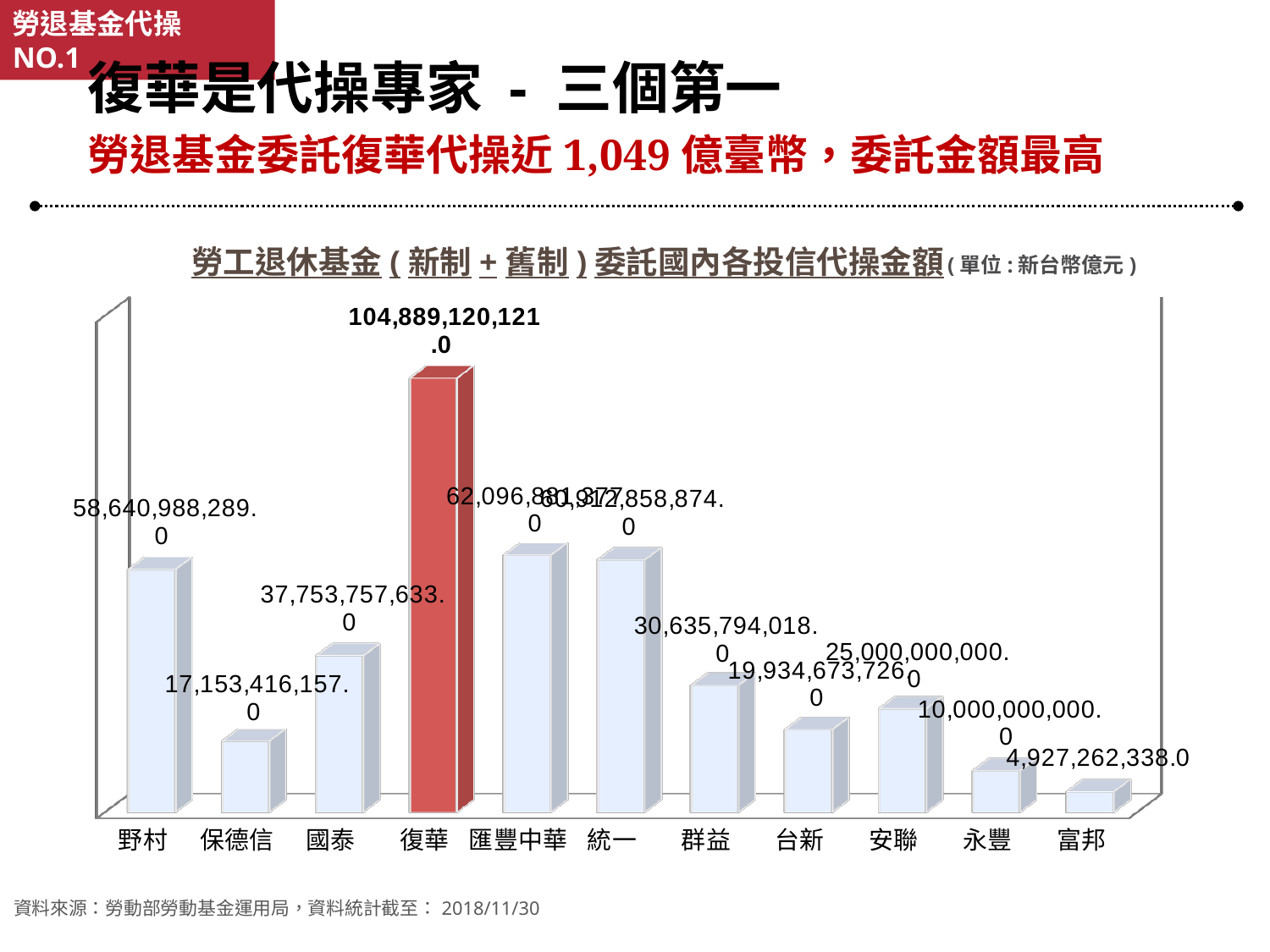
How many investment trust companies (categories) are shown on the x axis? 11 Which company has the highest entrusted amount? 復華 Which bar is coloured red instead of light blue? 復華 What is the value shown for 保德信? 17,153,416,157.0 What type of chart is shown on the slide? bar chart What is the value shown for 安聯? 25,000,000,000.0 What is the difference between the values for 安聯 and 永豐? 15,000,000,000.0 Which is larger, the value for 國泰 or the value for 群益? 國泰 What is the value shown for 野村? 58,640,988,289.0 What is the value shown for 富邦? 4,927,262,338.0 Which company has the lowest entrusted amount? 富邦 What is the value shown for 復華? 104,889,120,121.0